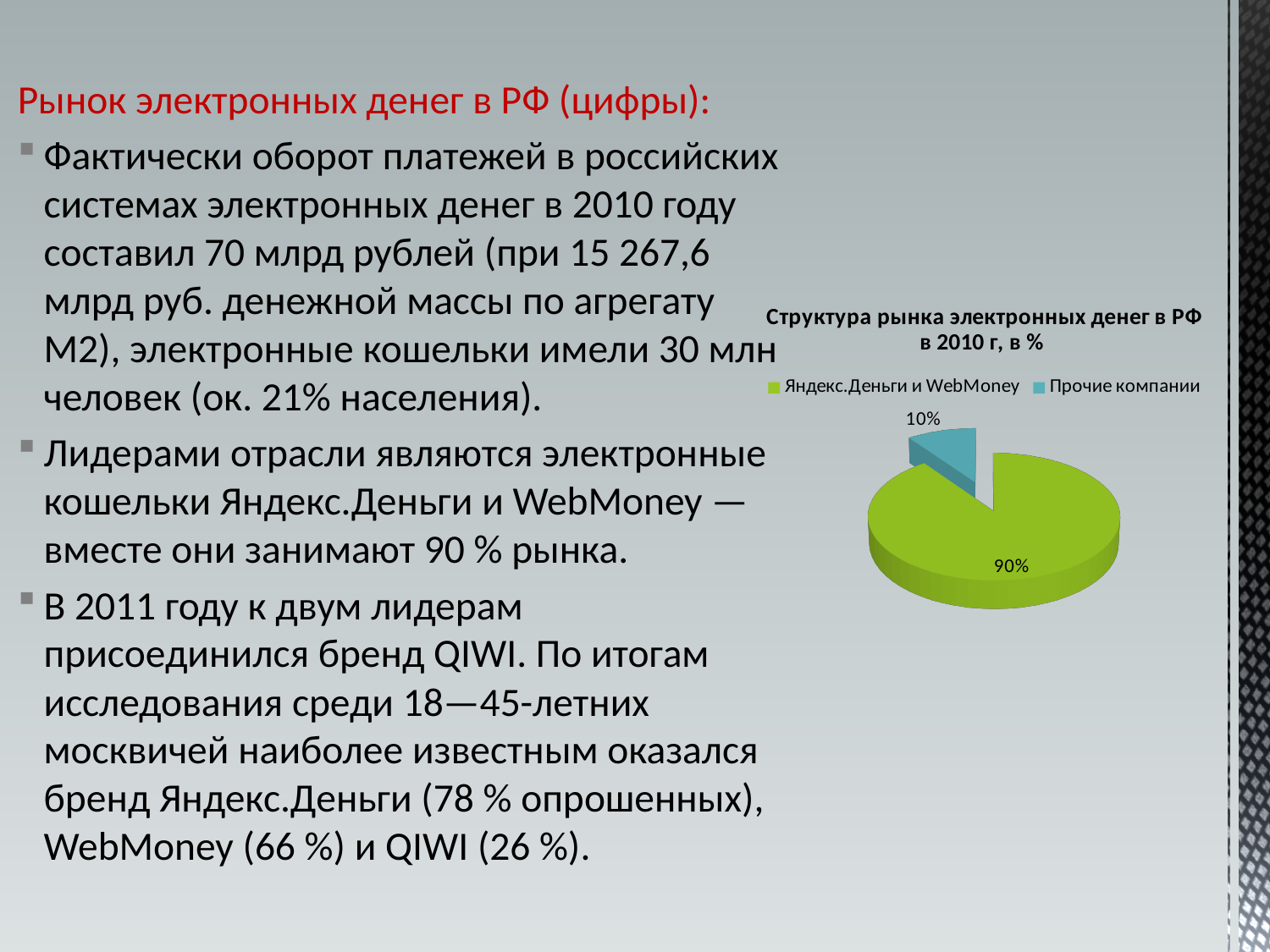
What share of the pie does Яндекс.Деньги и WebMoney hold? 90% What share of the pie does Прочие компании hold? 10% Which category has the largest slice of the pie? Яндекс.Деньги и WebMoney Which is larger: the share of Яндекс.Деньги и WebMoney or the share of Прочие компании? Яндекс.Деньги и WebMoney What is the title of the chart? Структура рынка электронных денег в РФ в 2010 г, в % How many slices does the pie chart have? 2 What kind of chart is shown on the slide? Pie chart Which category has the smallest slice of the pie? Прочие компании What is the difference between the shares of Яндекс.Деньги и WebMoney and Прочие компании? 80% How many entries does the legend list? 2 What colour is the slice for Прочие компании? Blue